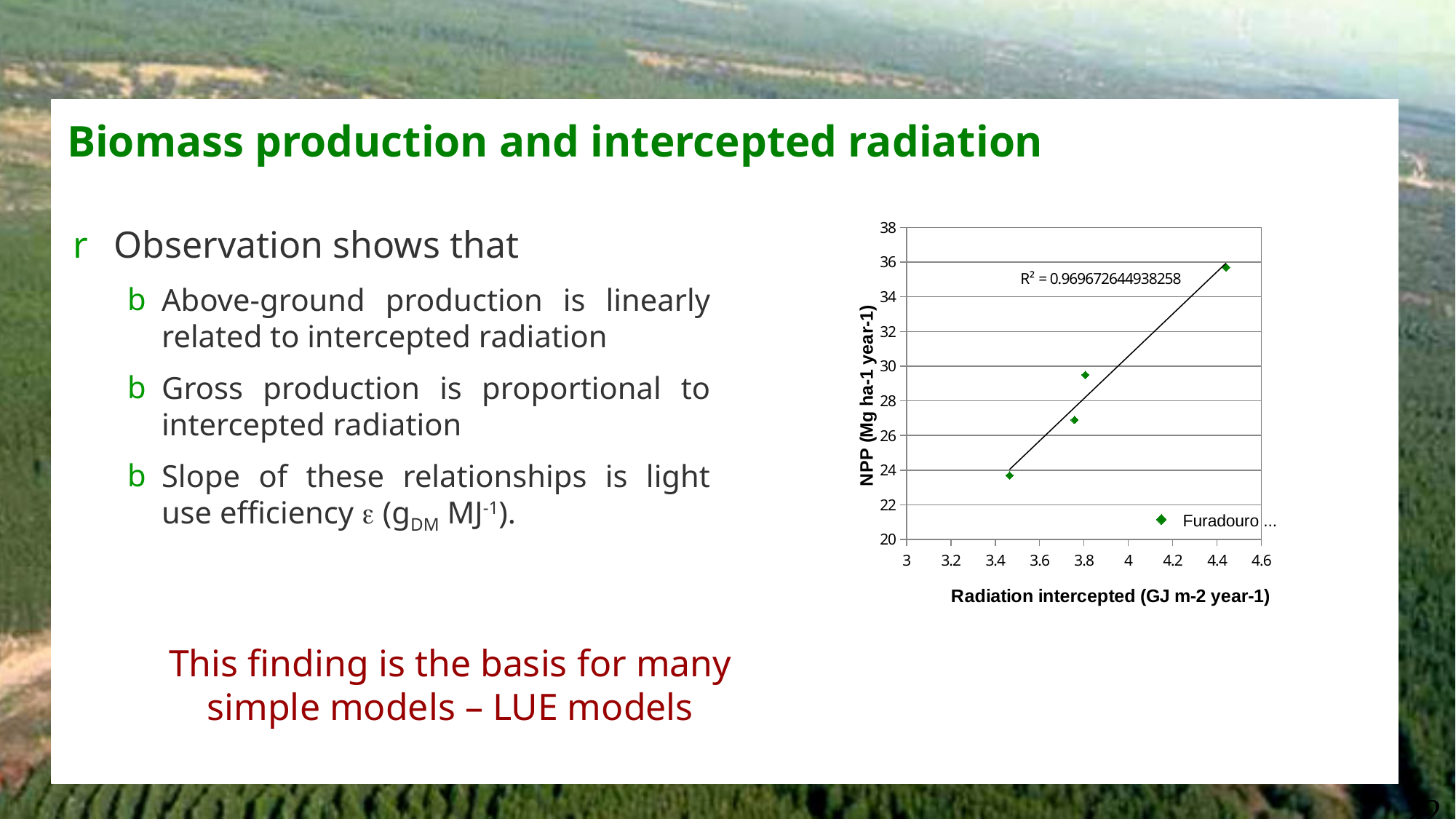
How many series does the chart legend list? 1 How many data points are plotted in the chart? 4 Is the NPP value of the rightmost data point (near 4.4 GJ m-2 year-1) greater or less than 34? greater What kind of chart is shown on the slide? scatter chart Do the NPP values rise or fall as radiation intercepted increases along the x axis? rise Is the NPP value of the leftmost data point (near 3.4 GJ m-2 year-1) greater or less than 26? less Is the NPP value of the lowest data point greater or less than 22? greater Which data point has the highest NPP: the one near 3.4 or the one near 4.4 GJ m-2 year-1 on the x axis? the one near 4.4 What R-squared value is printed on the chart? R² = 0.969672644938258 What is the title of the x axis of the chart? Radiation intercepted (GJ m-2 year-1)